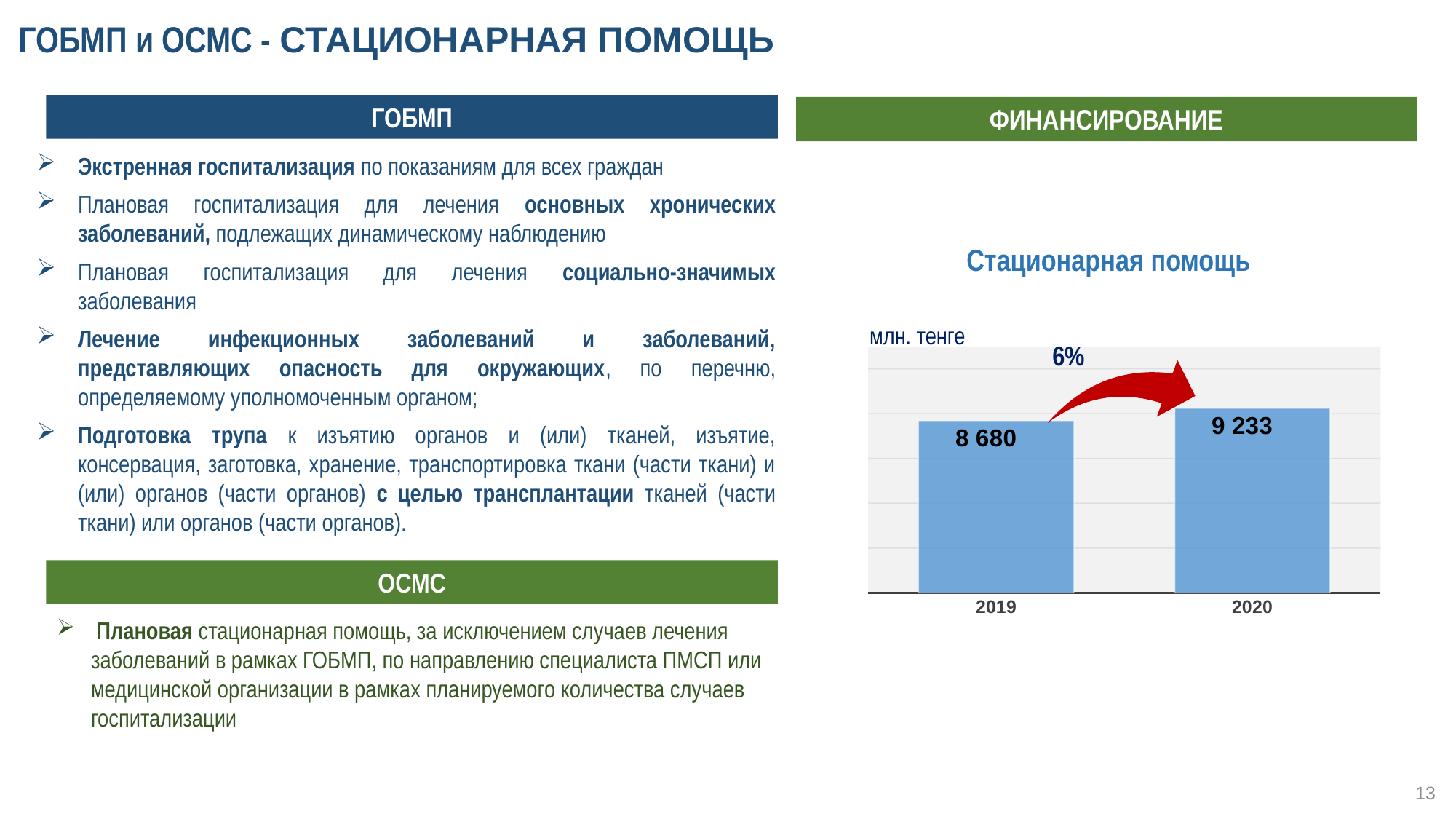
How many years are shown in the chart? 2 What is the title of the chart? Стационарная помощь What is the difference between the 2020 and 2019 values in the chart? 553 What is the value for 2020 in the chart? 9 233 What kind of chart is shown on the slide? Bar chart Which year has the lower value in the chart? 2019 What is the value for 2019 in the chart? 8 680 Do the values rise or fall from 2019 to 2020? Rise Which year has the higher value in the chart? 2020 What percentage change is annotated on the chart between 2019 and 2020? 6% Is the value for 2020 larger than the value for 2019? Yes